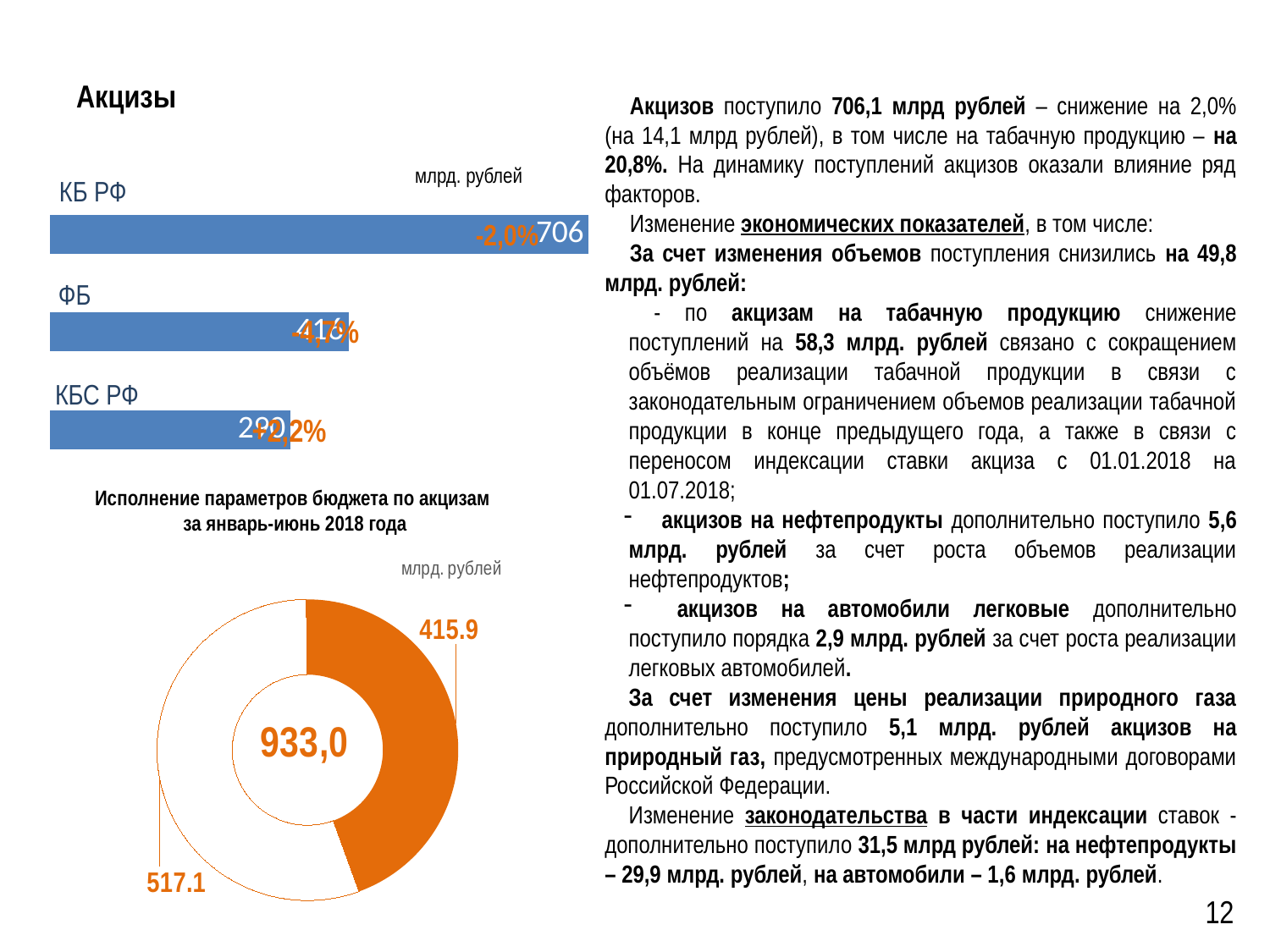
What type of chart is shown at the top left of the slide? Bar chart In the doughnut chart 'Исполнение параметров бюджета по акцизам за январь-июнь 2018 года', what value is shown in the centre? 933,0 In the bar chart at the top left, which category has the longest bar? КБ РФ How many categories are shown in the bar chart at the top left? 3 How many segments does the doughnut chart 'Исполнение параметров бюджета по акцизам за январь-июнь 2018 года' have? 2 In the doughnut chart 'Исполнение параметров бюджета по акцизам за январь-июнь 2018 года', what is the value of the orange segment? 415.9 In the bar chart at the top left, which bar is longer: ФБ or КБС РФ? ФБ In the bar chart at the top left, which category has the shortest bar? КБС РФ In the bar chart at the top left, what percentage change is shown next to the КБ РФ bar? -2,0% In the doughnut chart 'Исполнение параметров бюджета по акцизам за январь-июнь 2018 года', what is the difference between the two segment values, 517.1 and 415.9? 101.2 In the bar chart at the top left, what unit is indicated above the bars? млрд. рублей In the bar chart at the top left, what value is shown for КБ РФ? 706